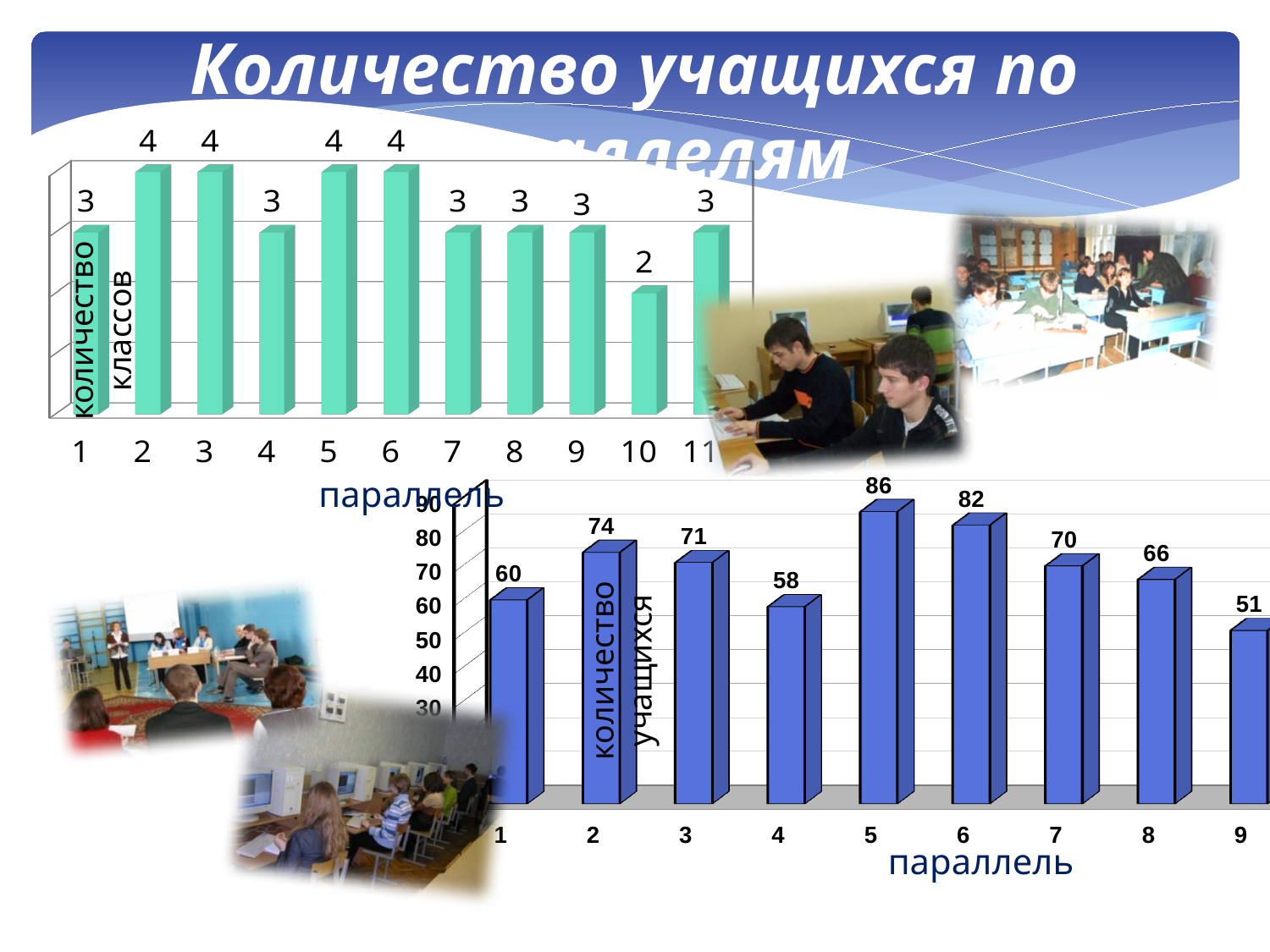
In the bottom chart (количество учащихся), what is the difference between the values for параллель 5 and параллель 4? 28 In the top chart (количество классов), which параллель has the lowest value? 10 In the top chart (количество классов), how many параллель categories are shown on the x axis? 11 In the top chart (количество классов), what is the value for параллель 10? 2 In the bottom chart (количество учащихся), what is the value for параллель 5? 86 In the bottom chart (количество учащихся), which is larger: the value for параллель 2 or параллель 3? параллель 2 In the bottom chart (количество учащихся), which параллель has the highest value? 5 In the top chart (количество классов), what is the value for параллель 5? 4 In the top chart (количество классов), what is the difference between the values for параллель 2 and параллель 10? 2 What type of chart is the bottom chart (количество учащихся)? bar chart In the bottom chart (количество учащихся), what is the value for параллель 9? 51